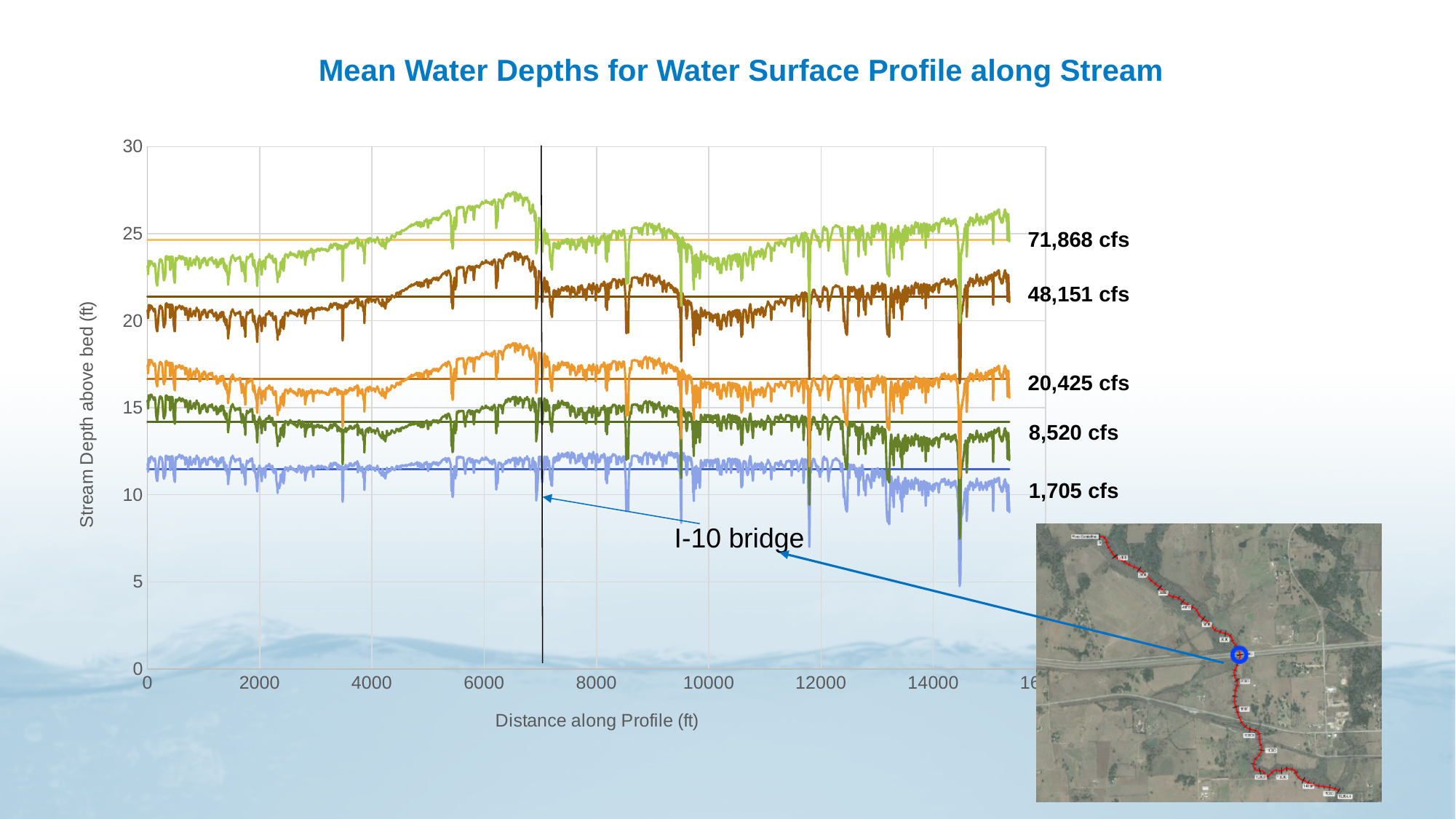
Which series shows a greater stream depth, 1,705 cfs or 20,425 cfs? 20,425 cfs How many discharge (cfs) series are plotted on the chart? 5 What feature does the vertical black line at about 7000 ft on the chart mark? I-10 bridge Is the stream depth for 20,425 cfs greater or less than 20 ft along the whole profile? less Is the mean depth line for 71,868 cfs greater or less than 20 ft? greater Which discharge series has the highest stream depth along the profile? 71,868 cfs Is the mean depth line for 1,705 cfs greater or less than 15 ft? less Which discharge series has the lowest stream depth along the profile? 1,705 cfs What is the title of the chart? Mean Water Depths for Water Surface Profile along Stream Which series shows a greater stream depth, 48,151 cfs or 8,520 cfs? 48,151 cfs What kind of chart is shown on the slide? line chart